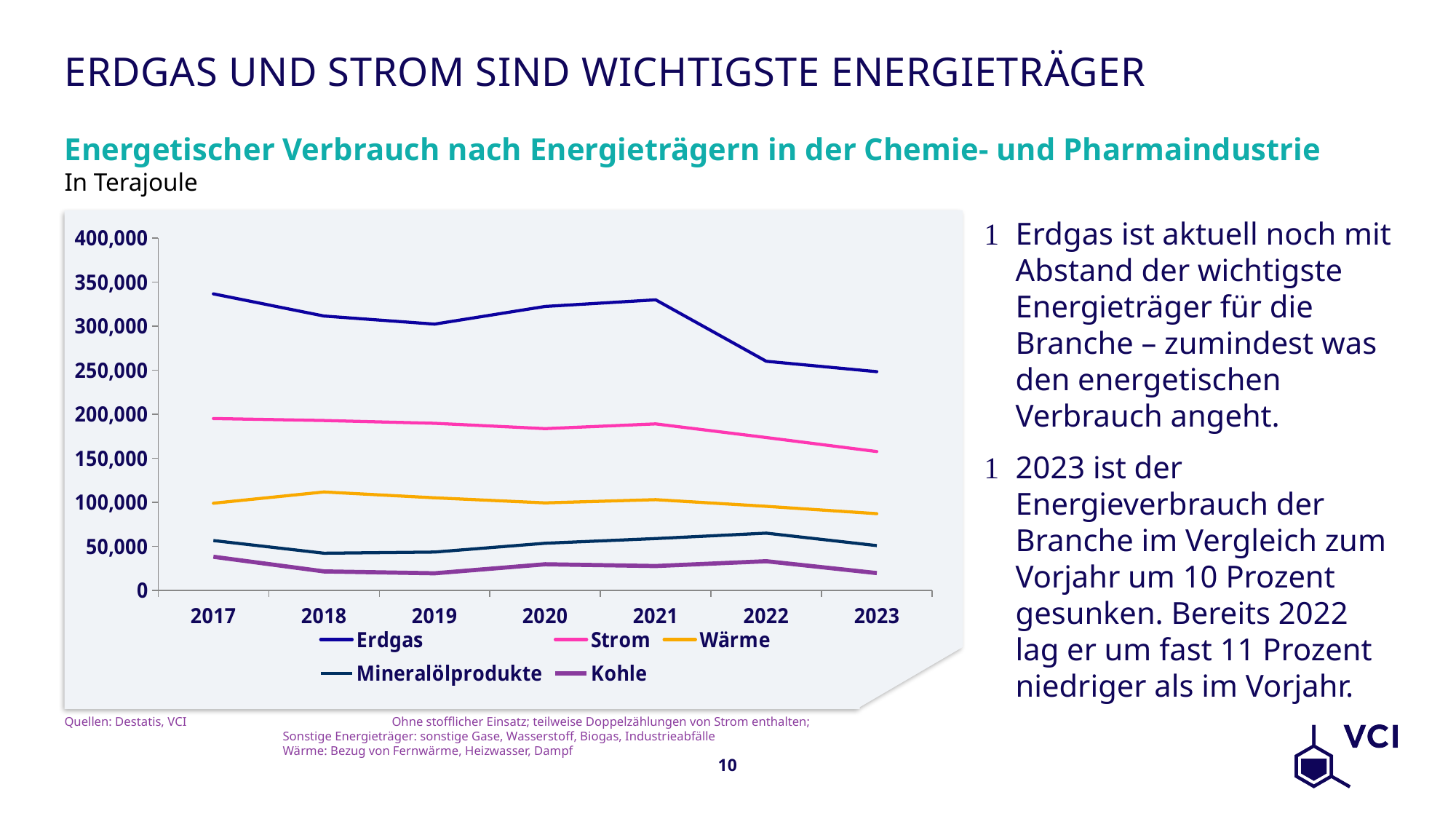
Is the value for Erdgas in 2017 greater or less than 300,000? greater How many series does the chart legend list? 5 Is the value for Strom in 2023 greater or less than 150,000? greater Does the Erdgas line rise or fall from 2021 to 2023? fall How many years are plotted along the x axis? 7 Is the value for Wärme in 2023 greater or less than 100,000? less Which is larger in 2021, Strom or Wärme? Strom Which energy source has the highest consumption in 2023? Erdgas In which year is the Wärme value highest? 2018 In which year is the Erdgas value lowest? 2023 What kind of chart is shown on the slide? line chart Which energy source has the lowest consumption in 2023? Kohle